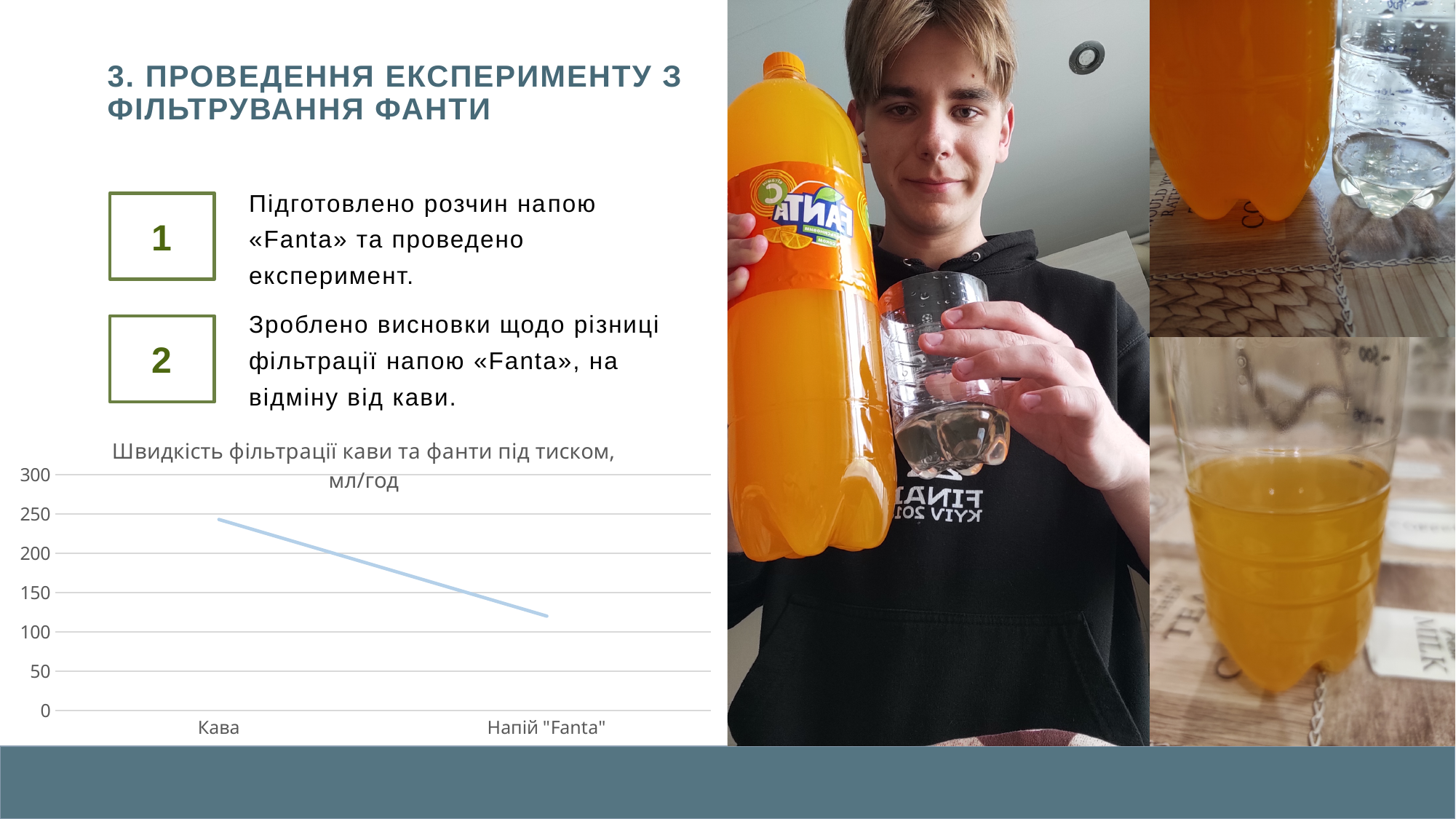
Do the values rise or fall from Кава to Напій "Fanta" along the x axis? fall Is the value for Кава greater or less than 300? less Which category has the lowest filtration rate in the chart? Напій "Fanta" How many categories are plotted on the x axis of the chart? 2 Is the value for Кава greater or less than 200? greater What is the title of the chart? Швидкість фільтрації кави та фанти під тиском, мл/год Which category has the highest filtration rate in the chart? Кава Is the value for Напій "Fanta" greater or less than 100? greater What kind of chart is shown on the slide? line chart What is the highest value shown on the chart's vertical axis? 300 Which has the larger value in the chart, Кава or Напій "Fanta"? Кава